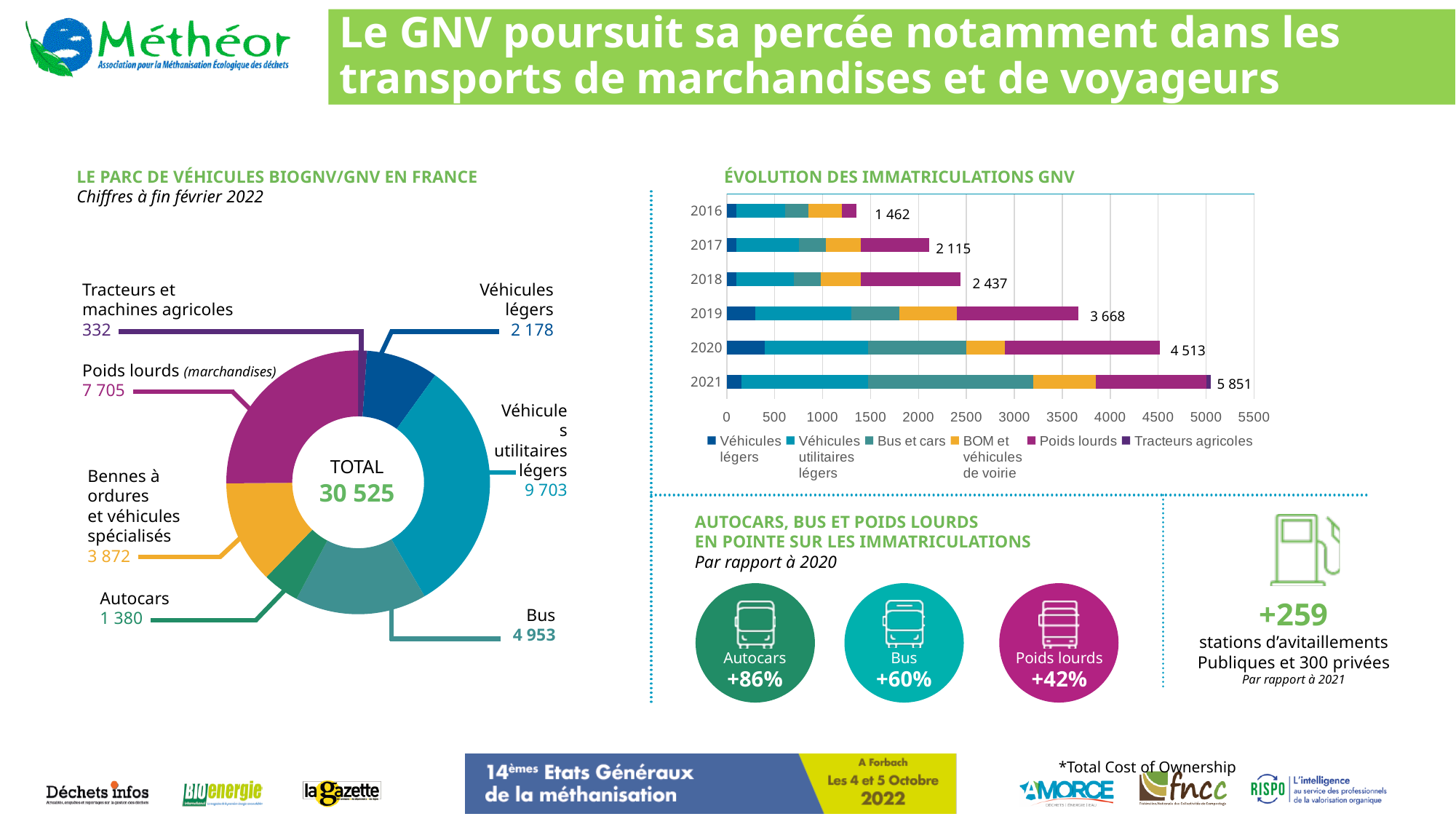
In the chart 'ÉVOLUTION DES IMMATRICULATIONS GNV', how many series does the legend list? 6 What kind of chart is 'ÉVOLUTION DES IMMATRICULATIONS GNV'? Stacked bar chart In the chart 'ÉVOLUTION DES IMMATRICULATIONS GNV', do the yearly totals rise or fall from 2016 to 2021? Rise In the chart 'LE PARC DE VÉHICULES BIOGNV/GNV EN FRANCE', which category has the lowest value? Tracteurs et machines agricoles In the chart 'ÉVOLUTION DES IMMATRICULATIONS GNV', what is the difference between the 2021 total and the 2020 total? 1 338 In the chart 'LE PARC DE VÉHICULES BIOGNV/GNV EN FRANCE', what is the difference between Bus and Autocars? 3 573 What kind of chart is 'LE PARC DE VÉHICULES BIOGNV/GNV EN FRANCE'? Donut (pie) chart In the chart 'LE PARC DE VÉHICULES BIOGNV/GNV EN FRANCE', what is the value for Poids lourds (marchandises)? 7 705 In the chart 'LE PARC DE VÉHICULES BIOGNV/GNV EN FRANCE', what total is shown in the centre of the donut? 30 525 In the chart 'ÉVOLUTION DES IMMATRICULATIONS GNV', what is the total for 2019? 3 668 In the chart 'LE PARC DE VÉHICULES BIOGNV/GNV EN FRANCE', which category has the highest value? Véhicules utilitaires légers In the chart 'LE PARC DE VÉHICULES BIOGNV/GNV EN FRANCE', how many categories are shown? 7